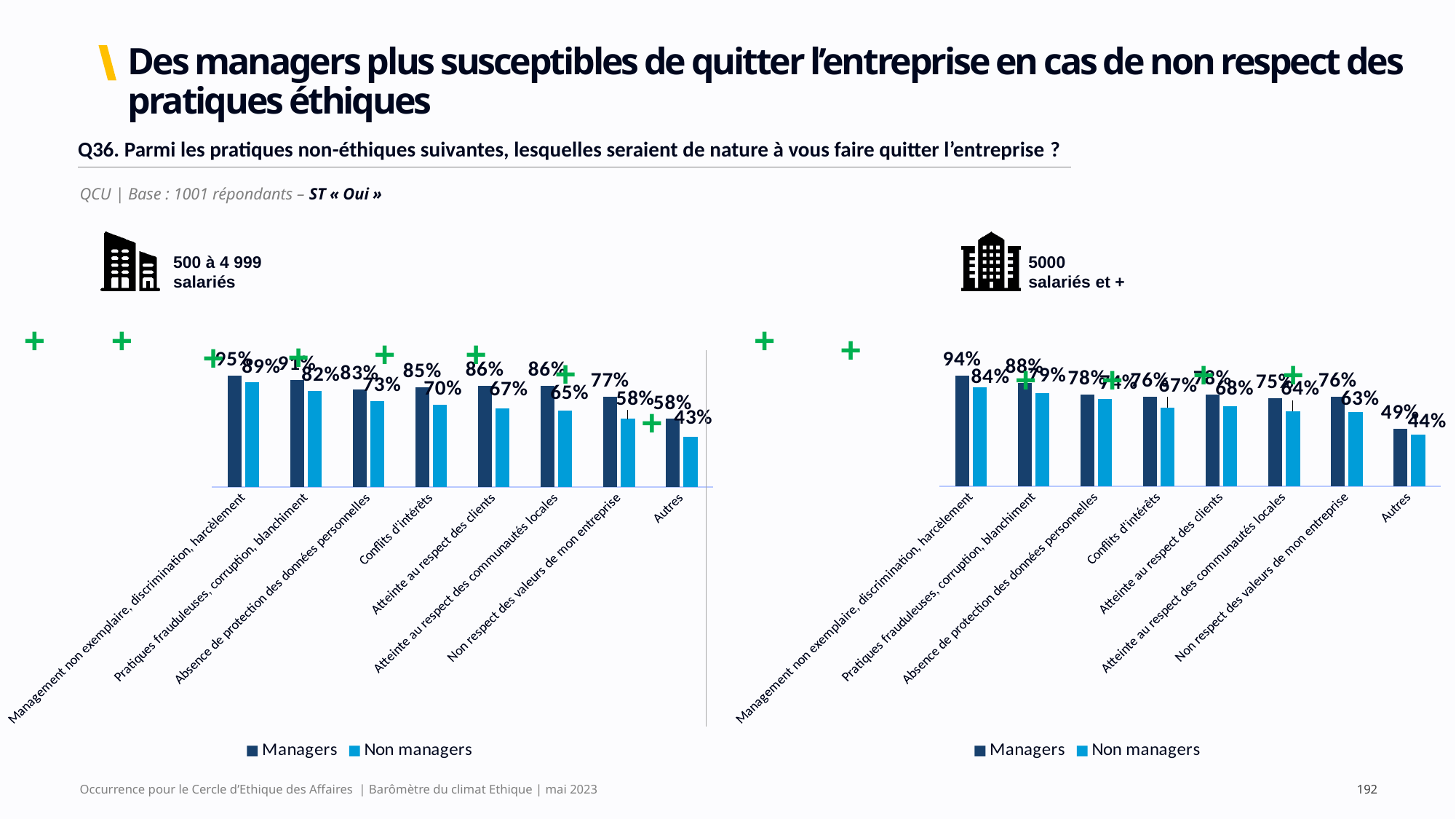
What type of chart is used for 500 à 4 999 salariés? Bar chart In the chart for 500 à 4 999 salariés, which category has the highest value for Managers? Management non exemplaire, discrimination, harcèlement In the chart for 5000 salariés et +, what is the value for Managers for Autres? 49% How many categories are shown in the chart for 5000 salariés et +? 8 In the chart for 500 à 4 999 salariés, which is larger for Non respect des valeurs de mon entreprise: Managers or Non managers? Managers In the chart for 500 à 4 999 salariés, what is the difference between Managers and Non managers for Conflits d'intérêts? 15 points In the chart for 5000 salariés et +, what is the difference between Managers and Non managers for Non respect des valeurs de mon entreprise? 13 points In the chart for 500 à 4 999 salariés, what is the value for Non managers for Autres? 43% In the chart for 5000 salariés et +, which category has the lowest value for Non managers? Autres In the chart for 5000 salariés et +, what is the value for Non managers for Management non exemplaire, discrimination, harcèlement? 84% In the chart for 500 à 4 999 salariés, what is the value for Managers for Management non exemplaire, discrimination, harcèlement? 95% How many series does the legend list in the chart for 500 à 4 999 salariés? 2